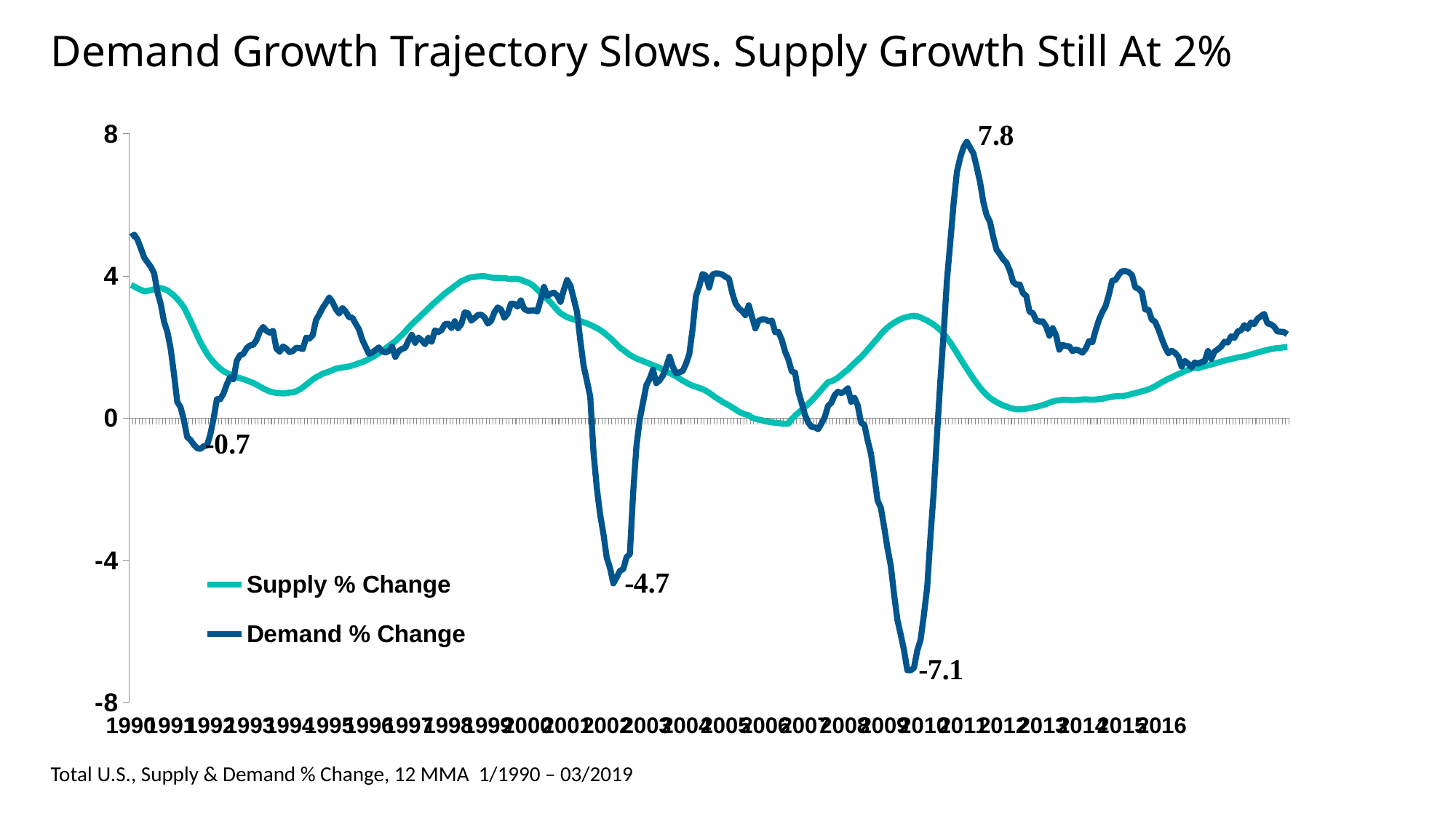
How many series does the legend list? 2 What colour is the Demand % Change line in the legend? dark blue What is the lowest labelled value on the Demand % Change line? -7.1 What is the difference between the labelled values -4.7 and -7.1 on the Demand % Change line? 2.4 What value is labelled on the Demand % Change line at its dip around 2002? -4.7 What is the difference between the highest labelled value (7.8) and the lowest labelled value (-7.1) on the Demand % Change line? 14.9 Is the value of Supply % Change around 2013 greater or less than 4? less What value is labelled on the Demand % Change line at its dip around 1992? -0.7 What is the highest labelled value on the Demand % Change line? 7.8 What kind of chart is shown on the slide? line chart Which series reaches the highest value on the chart, Supply % Change or Demand % Change? Demand % Change How many data labels are printed on the chart? 4